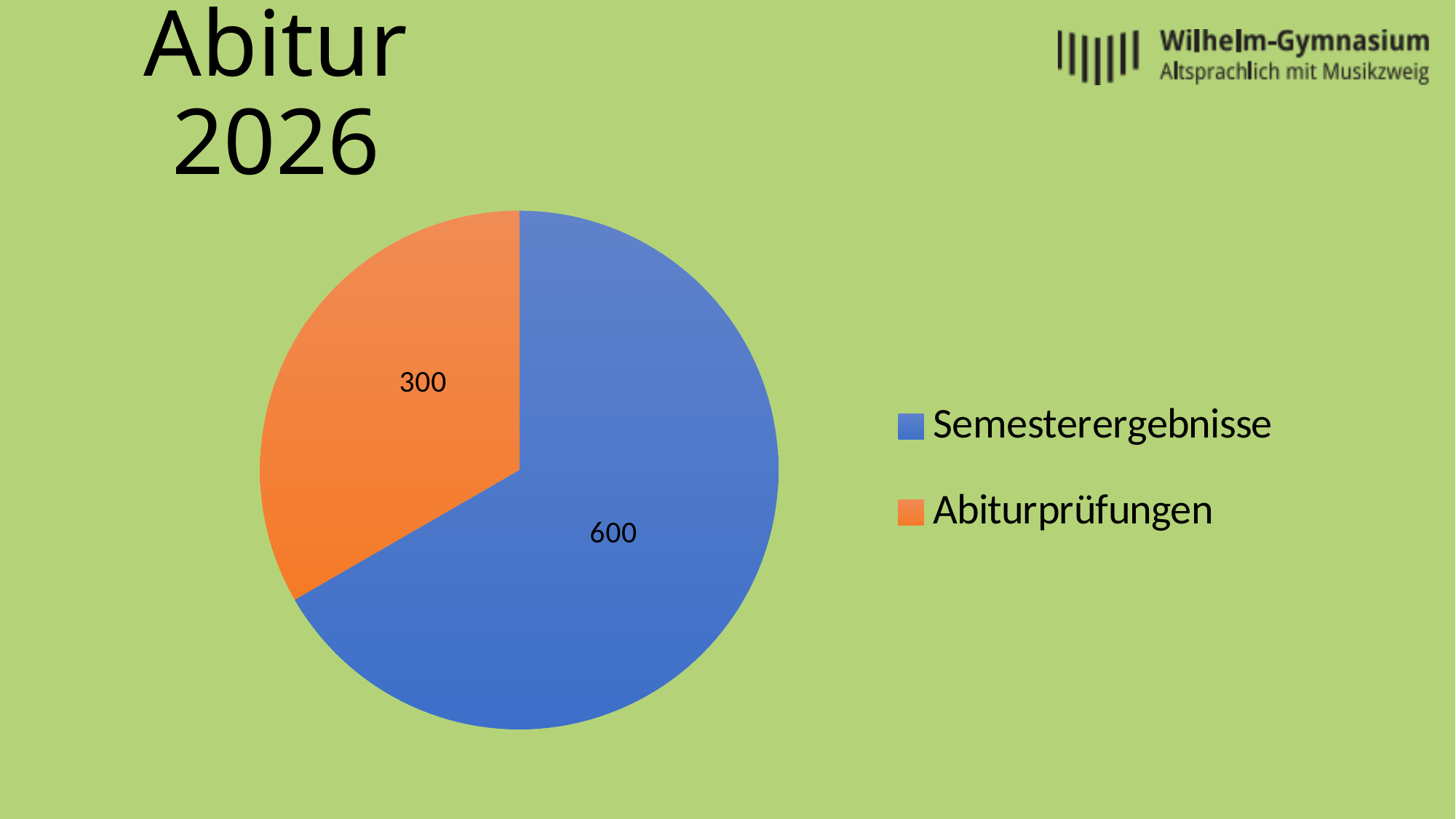
Which category has the largest slice of the pie? Semesterergebnisse What share of the pie does Abiturprüfungen represent? One third What is the value for Abiturprüfungen? 300 Which is larger, Semesterergebnisse or Abiturprüfungen? Semesterergebnisse What is the total of all slices in the pie chart? 900 Which category has the smallest slice of the pie? Abiturprüfungen How many entries does the legend list? 2 What is the difference between the values for Semesterergebnisse and Abiturprüfungen? 300 What is the value for Semesterergebnisse? 600 What kind of chart is shown on the slide? Pie chart How many slices does the pie chart have? 2 What colour is the Abiturprüfungen slice? Orange